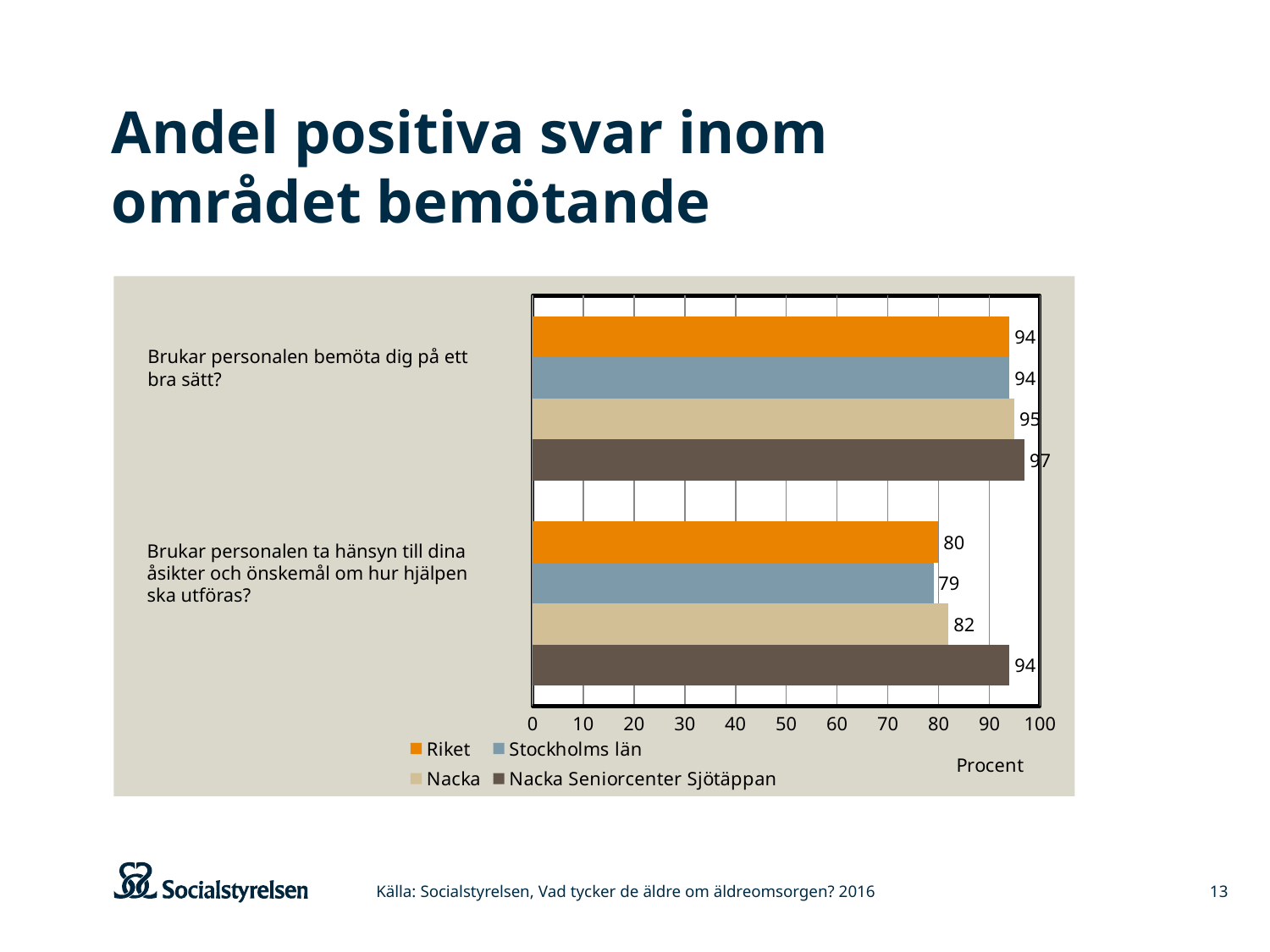
Which series has the highest value for the question "Brukar personalen ta hänsyn till dina åsikter och önskemål om hur hjälpen ska utföras?"? Nacka Seniorcenter Sjötäppan What is the value for Nacka for the question "Brukar personalen bemöta dig på ett bra sätt?"? 95 What is the value for Stockholms län for the question "Brukar personalen ta hänsyn till dina åsikter och önskemål om hur hjälpen ska utföras?"? 79 How many series does the legend list? 4 What unit is shown on the horizontal axis of the chart? Procent Which is larger for the question "Brukar personalen bemöta dig på ett bra sätt?": Nacka or Riket? Nacka How many question categories are shown on the chart? 2 What type of chart is shown on the slide? bar chart What is the value for Nacka Seniorcenter Sjötäppan for the question "Brukar personalen bemöta dig på ett bra sätt?"? 97 Which series has the lowest value for the question "Brukar personalen ta hänsyn till dina åsikter och önskemål om hur hjälpen ska utföras?"? Stockholms län What is the difference between Nacka Seniorcenter Sjötäppan and Nacka for the question "Brukar personalen ta hänsyn till dina åsikter och önskemål om hur hjälpen ska utföras?"? 12 What is the value for Riket for the question "Brukar personalen ta hänsyn till dina åsikter och önskemål om hur hjälpen ska utföras?"? 80